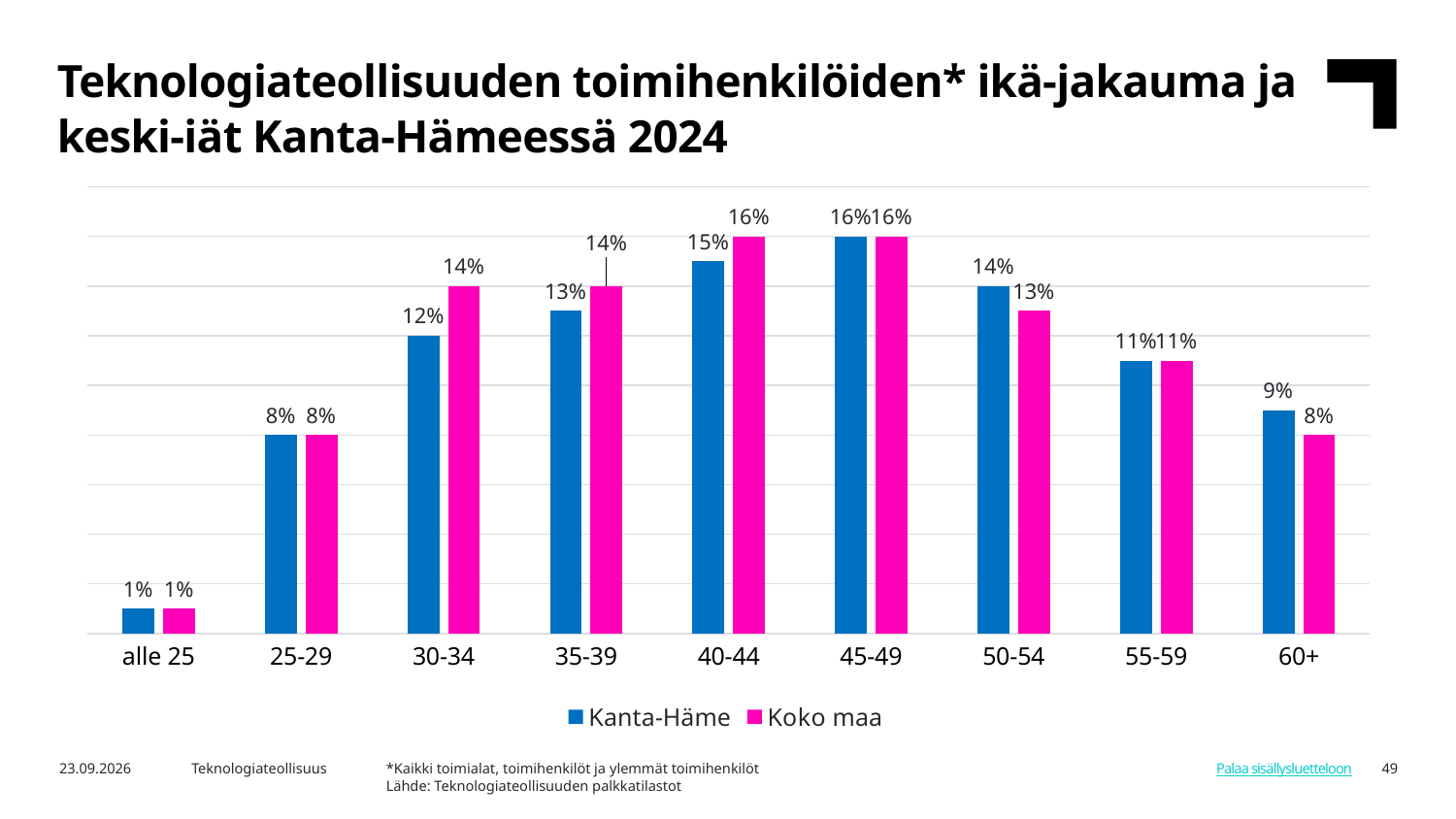
What kind of chart is shown on the slide? Bar chart What is the difference between Koko maa and Kanta-Häme in the 30-34 age group? 2% What is the value for Koko maa in the 50-54 age group? 13% Which is larger in the 50-54 age group, Kanta-Häme or Koko maa? Kanta-Häme How many age groups are shown on the x axis? 9 Which age group has the highest value for Kanta-Häme? 45-49 Which colour represents Koko maa in the chart? Pink Which is larger in the 35-39 age group, Kanta-Häme or Koko maa? Koko maa What is the value for Kanta-Häme in the 60+ age group? 9% How many series does the legend list? 2 What is the value for Kanta-Häme in the 30-34 age group? 12% Which age group has the lowest value for Koko maa? alle 25